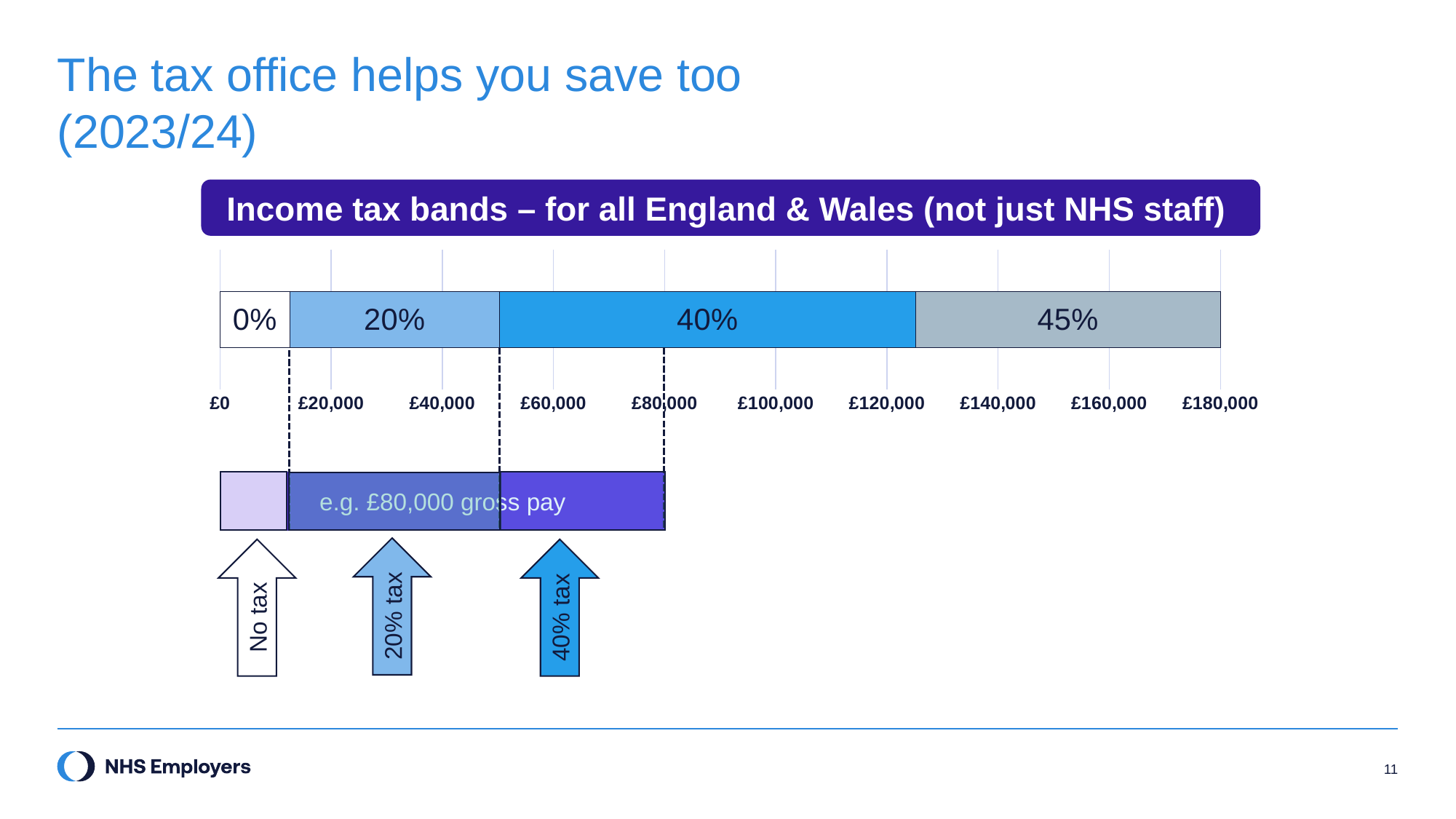
Is the upper limit of the 40% band greater or less than £140,000? less What is the highest income value labelled on the axis? £180,000 Which tax rate applies to income at £100,000 according to the bar? 40% What is the highest tax rate shown in the bar? 45% Which tax band covers the narrowest range of income on the bar? 0% What example gross pay is shown in the lower bar? £80,000 Is the upper limit of the 20% band greater or less than £60,000? less What is the lowest tax rate shown in the bar? 0% What kind of chart is used to show the income tax bands? Bar chart How many tax bands are shown in the bar? 4 What is the title of the chart? Income tax bands – for all England & Wales (not just NHS staff) Which tax band covers the widest range of income on the bar? 40%